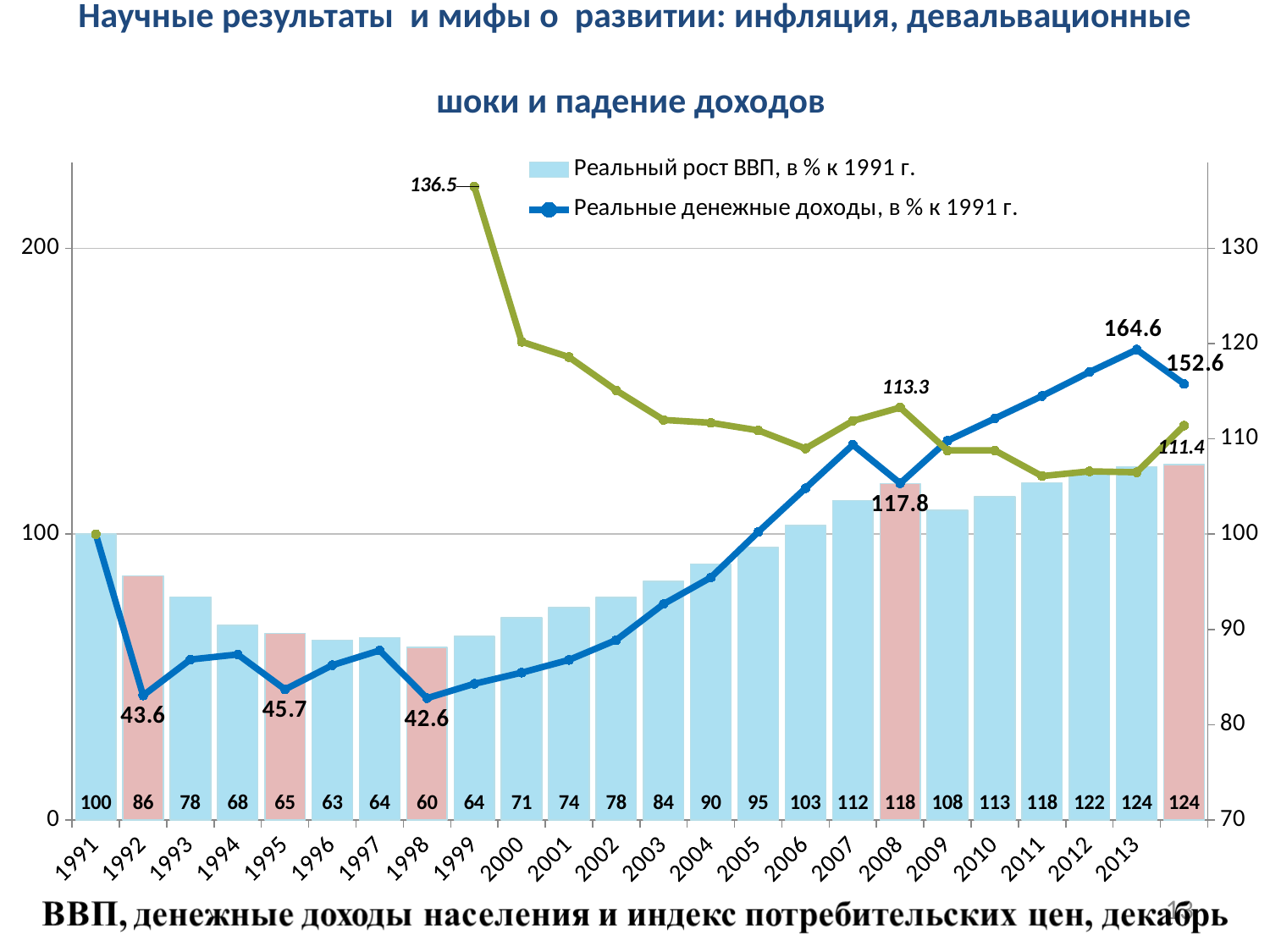
What is the difference between the real GDP growth bars for 1991 and 1998? 40 Which year has the lowest real GDP growth bar? 1998 How many series does the legend list? 2 Do the real GDP growth bars rise or fall from 1991 to 1998? fall Which year has the larger real GDP growth bar, 2005 or 2006? 2006 Is the value of the real money incomes line in 2004 greater or less than 100? less What value is labelled on the real money incomes line for 2013? 164.6 What is the value of the real GDP growth bar for 2008? 118 What is the value of the real GDP growth bar for 1998? 60 What value is labelled on the real money incomes line for 1992? 43.6 What value is labelled on the olive line at 1999? 136.5 What is the difference between the real GDP growth bars for 2008 and 2009? 10